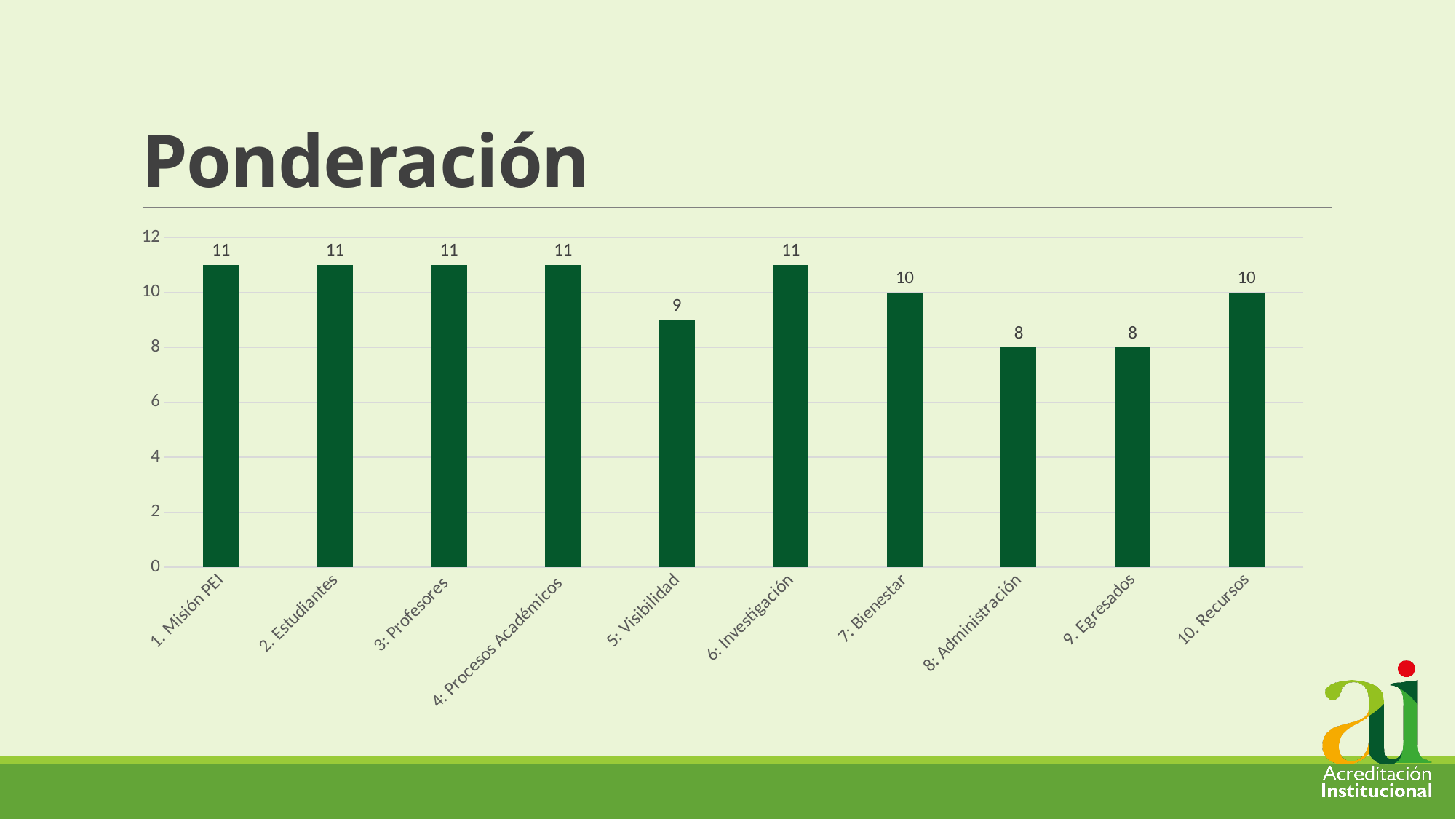
What is the value for 5: Visibilidad? 9 Which is larger, the value for 6: Investigación or the value for 10. Recursos? 6: Investigación What is the value for 8: Administración? 8 What is the title of the slide? Ponderación What is the value for 7: Bienestar? 10 What is the difference between the values for 1. Misión PEI and 9. Egresados? 3 What is the value for 1. Misión PEI? 11 What kind of chart is shown on the slide? bar chart How many categories are shown on the x axis? 10 Is the value for 9. Egresados greater or less than 10? less What is the difference between the values for 7: Bienestar and 5: Visibilidad? 1 Which is larger, the value for 5: Visibilidad or the value for 8: Administración? 5: Visibilidad